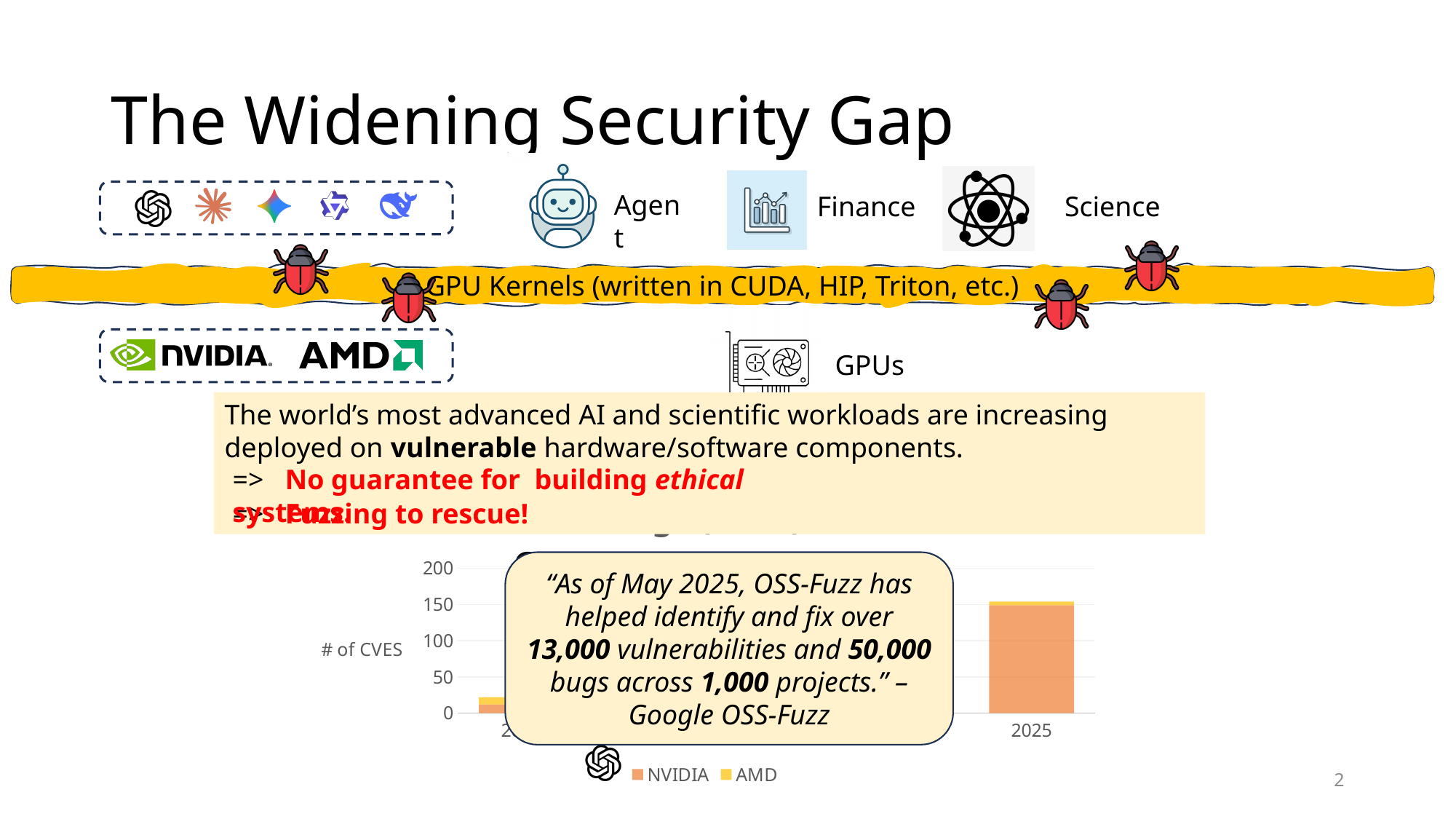
What kind of chart is shown at the bottom of the slide? bar chart What is the highest tick value shown on the chart's vertical axis? 200 Which two series are listed in the chart's legend? NVIDIA and AMD How many series does the chart's legend list? 2 What is the label on the chart's vertical axis? # of CVES Is the total value of the 2025 bar greater or less than 200? less Is the total value of the 2025 bar greater or less than 100? greater Is the NVIDIA value for 2025 greater or less than 50? greater